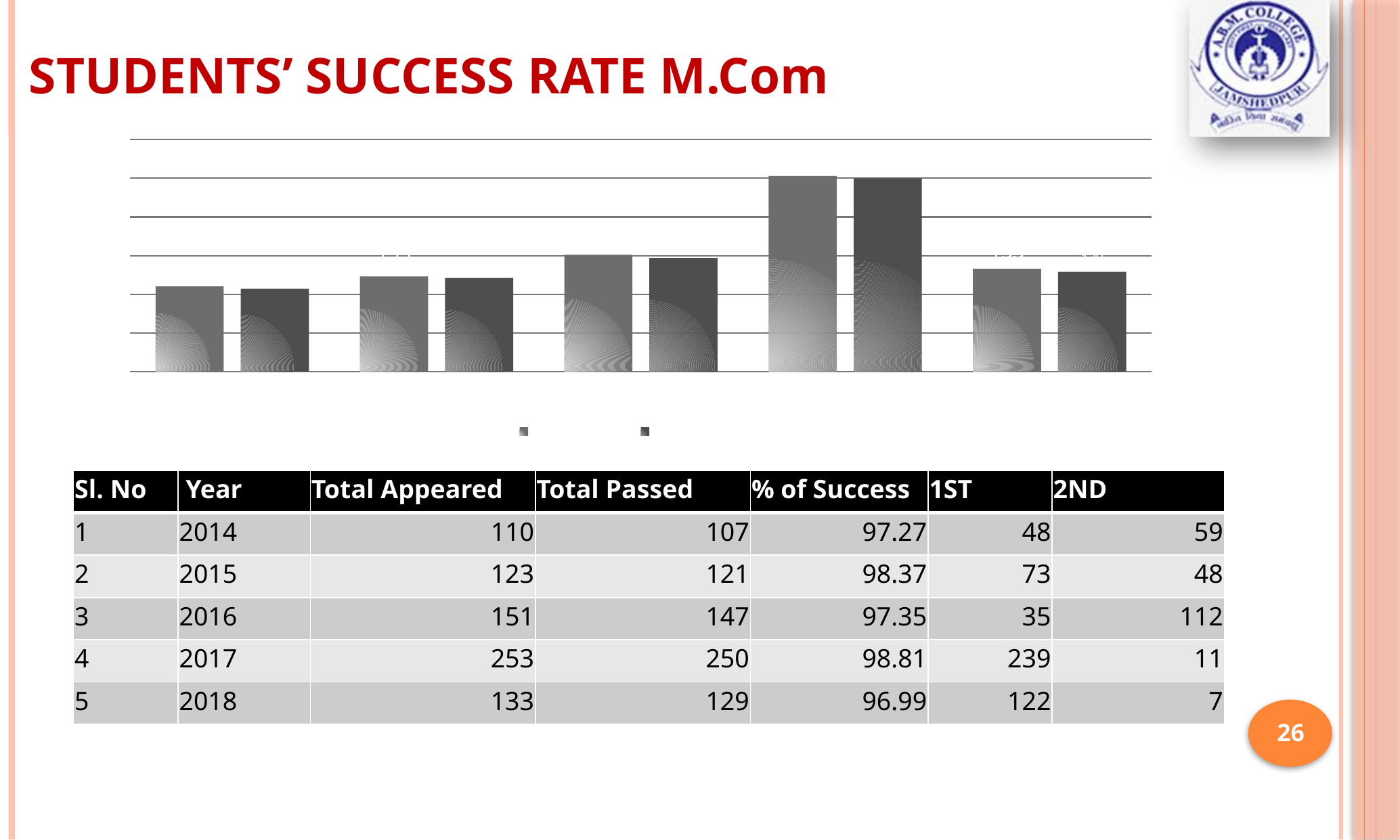
In the chart, is the fourth group of bars taller or shorter than the fifth group? taller How many groups of bars does the chart show? 5 Which group of bars in the chart is the tallest? the fourth group from the left What kind of chart is shown on the slide? bar chart Which group of bars in the chart is the shortest? the first group from the left In each group of the chart, is the lighter bar taller or shorter than the darker bar? taller How many series does the chart's legend list? 2 Do the bars in the chart rise or fall from the first group to the fourth group? rise